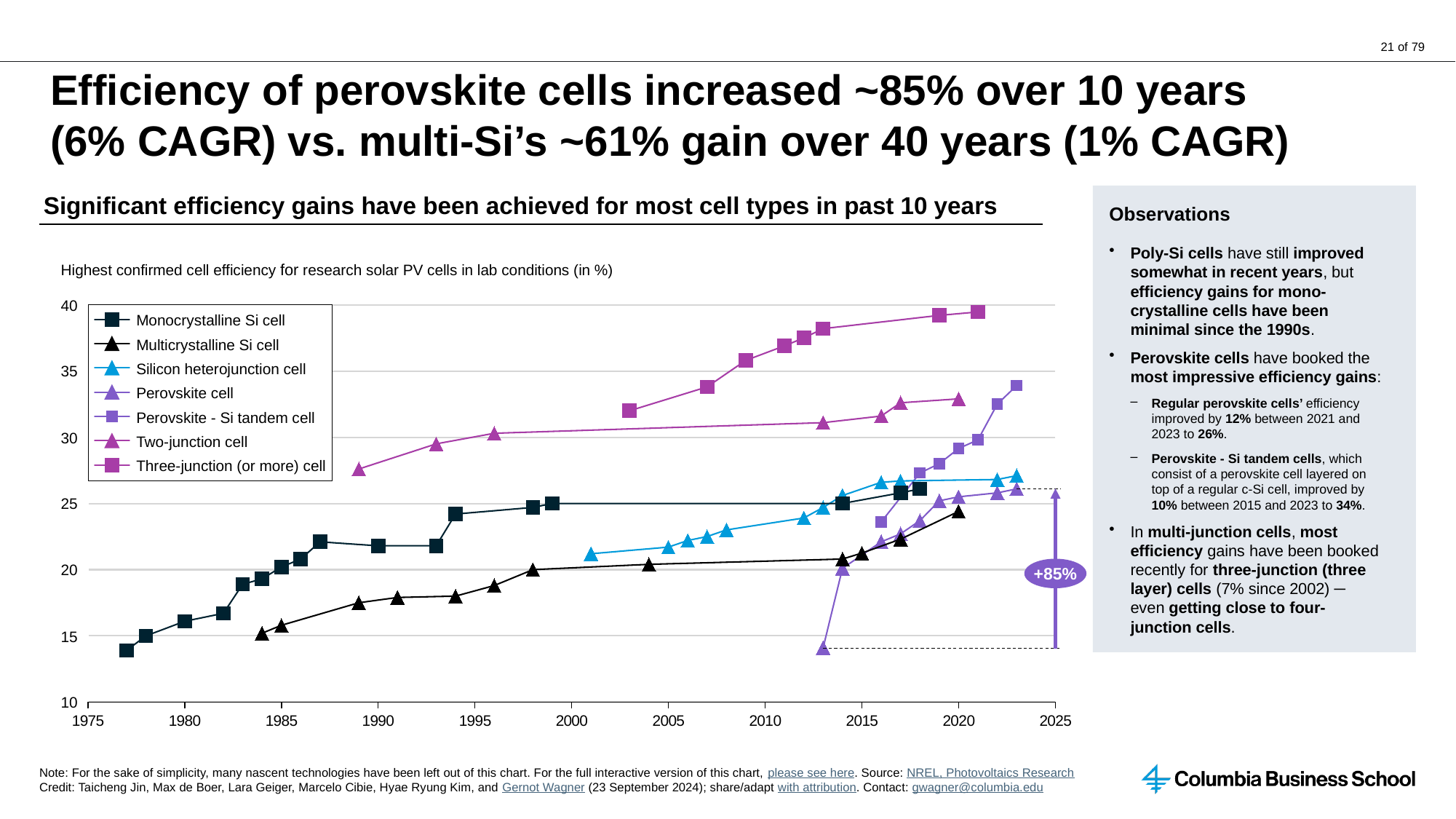
Which series has the highest efficiency values on the chart? Three-junction (or more) cell How many series does the chart's legend list? 7 What percentage gain does the annotation on the right of the chart show for the Perovskite cell? +85% What does the chart's subtitle say is being measured? Highest confirmed cell efficiency for research solar PV cells in lab conditions (in %) Is the value for the Three-junction (or more) cell in 2021 greater or less than 35? greater Is the value for the Perovskite cell in 2013 greater or less than 15? less What kind of chart is shown on the slide? Line chart Do the values for the Perovskite cell rise or fall over time? Rise In 2020, which is larger: the Two-junction cell value or the Silicon heterojunction cell value? Two-junction cell Is the value for the Perovskite - Si tandem cell in 2023 greater or less than 30? greater